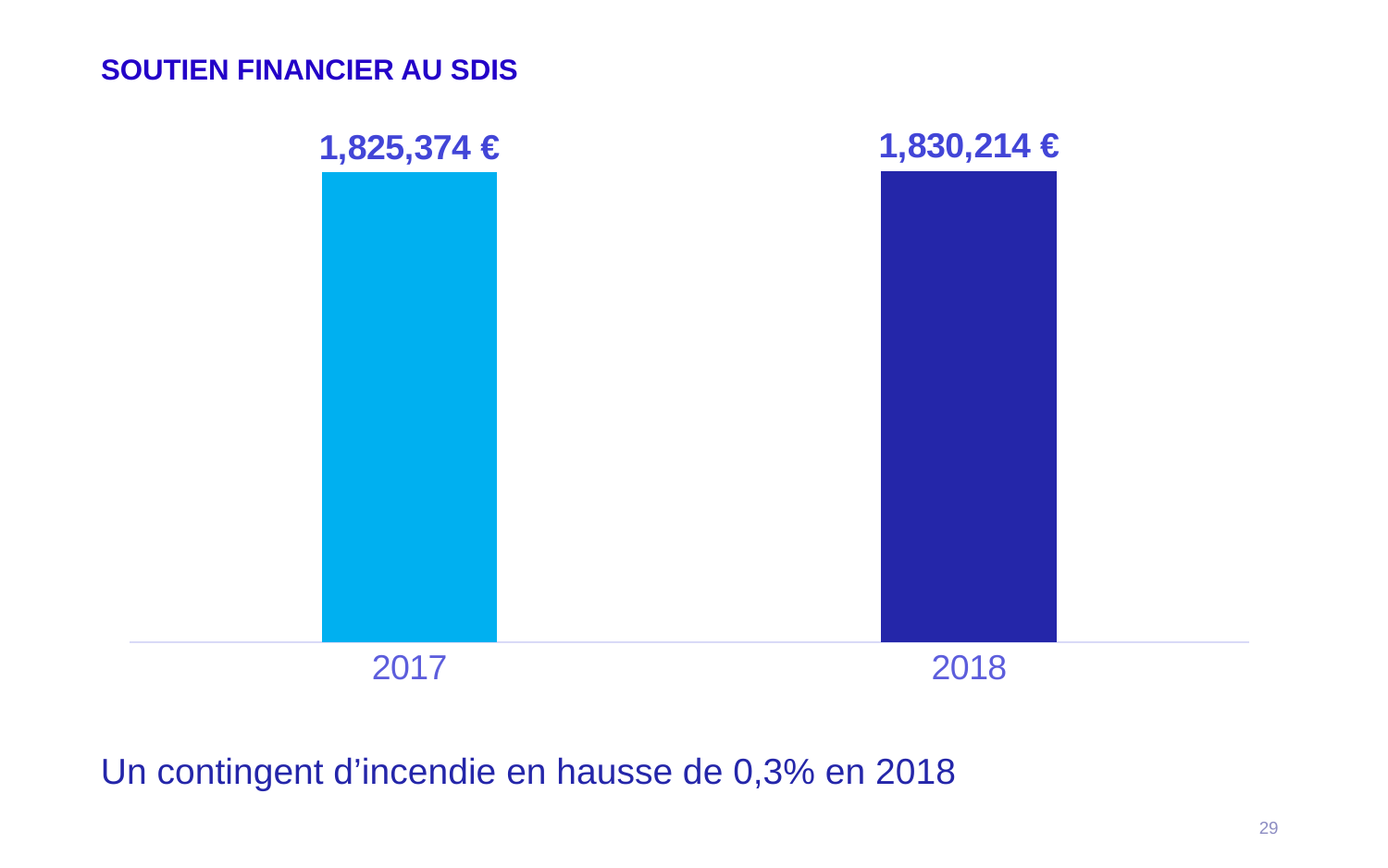
What kind of chart is shown on the slide? bar chart What is the value shown for 2018? 1,830,214 € What is the difference between the 2018 and 2017 values? 4,840 € What is the title of the chart? SOUTIEN FINANCIER AU SDIS Do the values rise or fall from 2017 to 2018? rise Which year has the lower value according to the data labels? 2017 Is the value for 2018 larger or smaller than the value for 2017? larger What colour is the bar for 2018? dark blue What is the value shown for 2017? 1,825,374 € How many bars are plotted in the chart? 2 Which year has the higher value according to the data labels? 2018